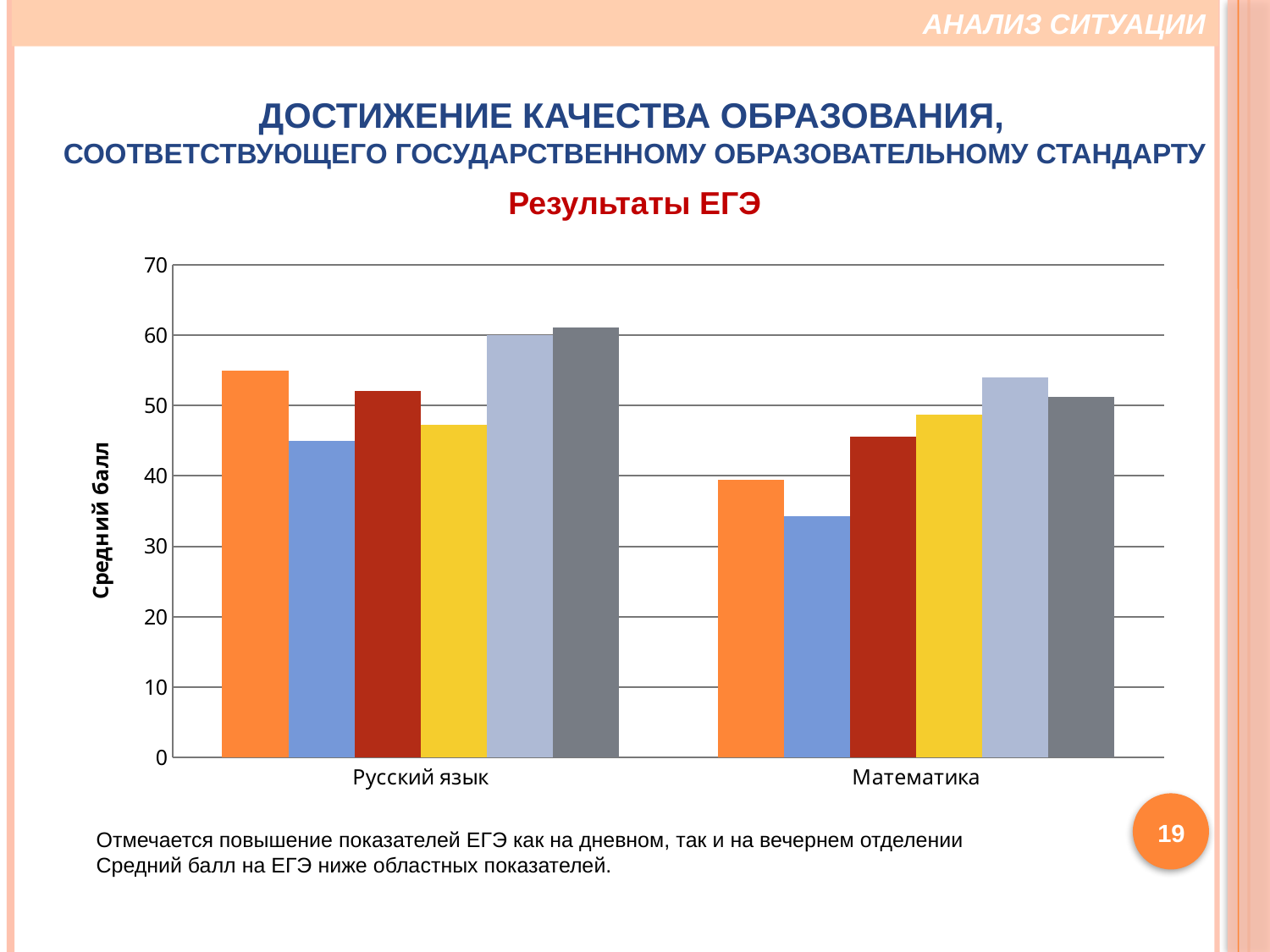
Is the value of the grey bar for Математика greater or less than 40? greater Which bar is the lowest in the Математика group? the blue bar Which bar is the lowest in the Русский язык group? the blue bar What is the label of the vertical axis? Средний балл What is the title of the chart? Результаты ЕГЭ Is the orange bar higher for Русский язык or for Математика? Русский язык How many categories are shown on the x axis of the chart? 2 What kind of chart is shown on the slide? bar chart Is the value of the orange bar for Русский язык greater or less than 50? greater Is the value of the light blue bar for Русский язык greater or less than 50? greater How many bars are plotted for the category Русский язык? 6